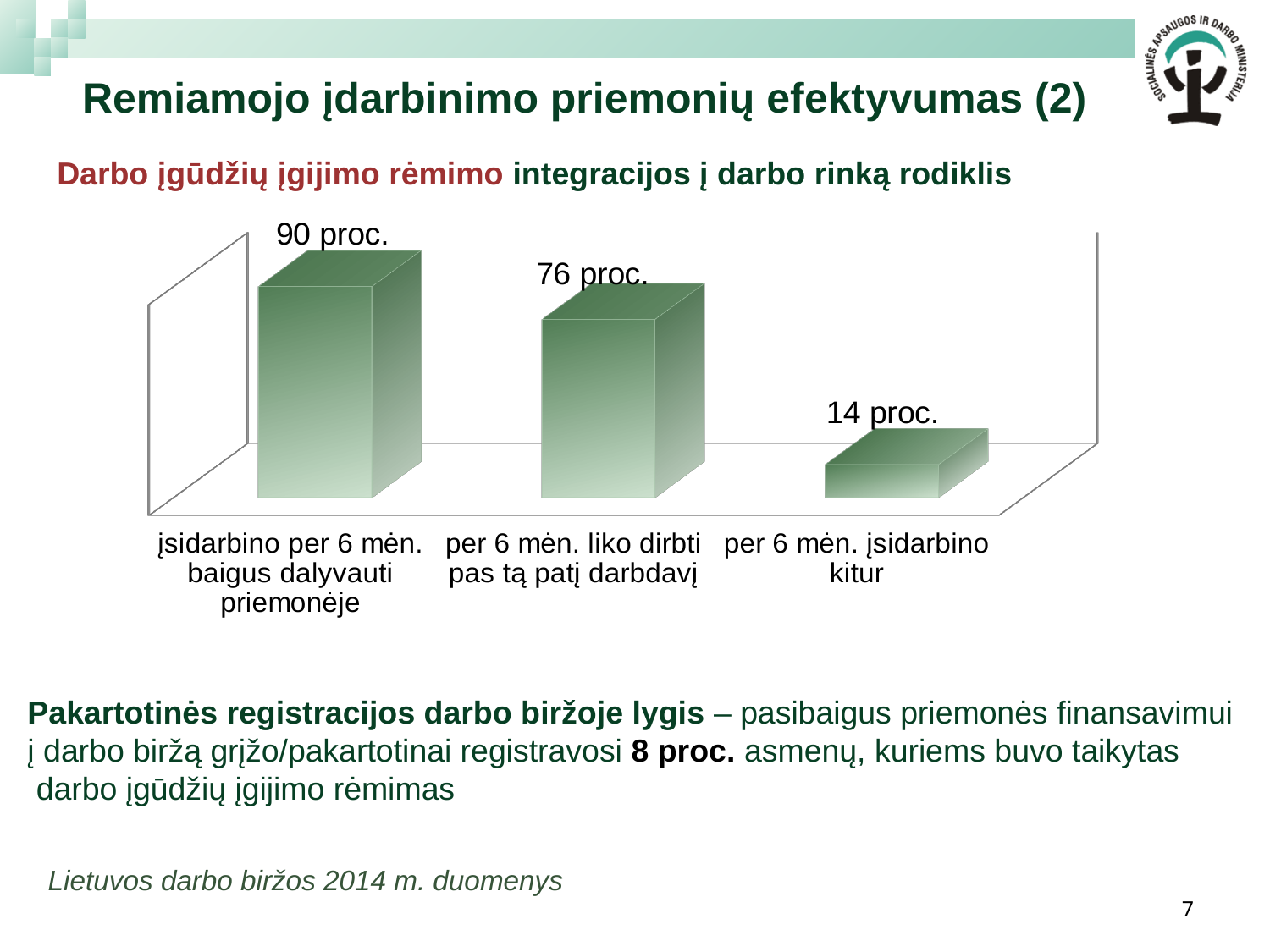
Which category has the lowest value? per 6 mėn. įsidarbino kitur What is the value for "įsidarbino per 6 mėn. baigus dalyvauti priemonėje"? 90 proc. What is the title of the chart? Darbo įgūdžių įgijimo rėmimo integracijos į darbo rinką rodiklis Do the values rise or fall from left to right across the categories? fall Which is larger: the value for "per 6 mėn. liko dirbti pas tą patį darbdavį" or for "per 6 mėn. įsidarbino kitur"? per 6 mėn. liko dirbti pas tą patį darbdavį How many categories are shown in the chart? 3 What is the value for "per 6 mėn. įsidarbino kitur"? 14 proc. What is the difference between the values for "įsidarbino per 6 mėn. baigus dalyvauti priemonėje" and "per 6 mėn. liko dirbti pas tą patį darbdavį"? 14 proc. What is the difference between the values for "per 6 mėn. liko dirbti pas tą patį darbdavį" and "per 6 mėn. įsidarbino kitur"? 62 proc. Which category has the highest value? įsidarbino per 6 mėn. baigus dalyvauti priemonėje What kind of chart is shown on the slide? bar chart What is the value for "per 6 mėn. liko dirbti pas tą patį darbdavį"? 76 proc.